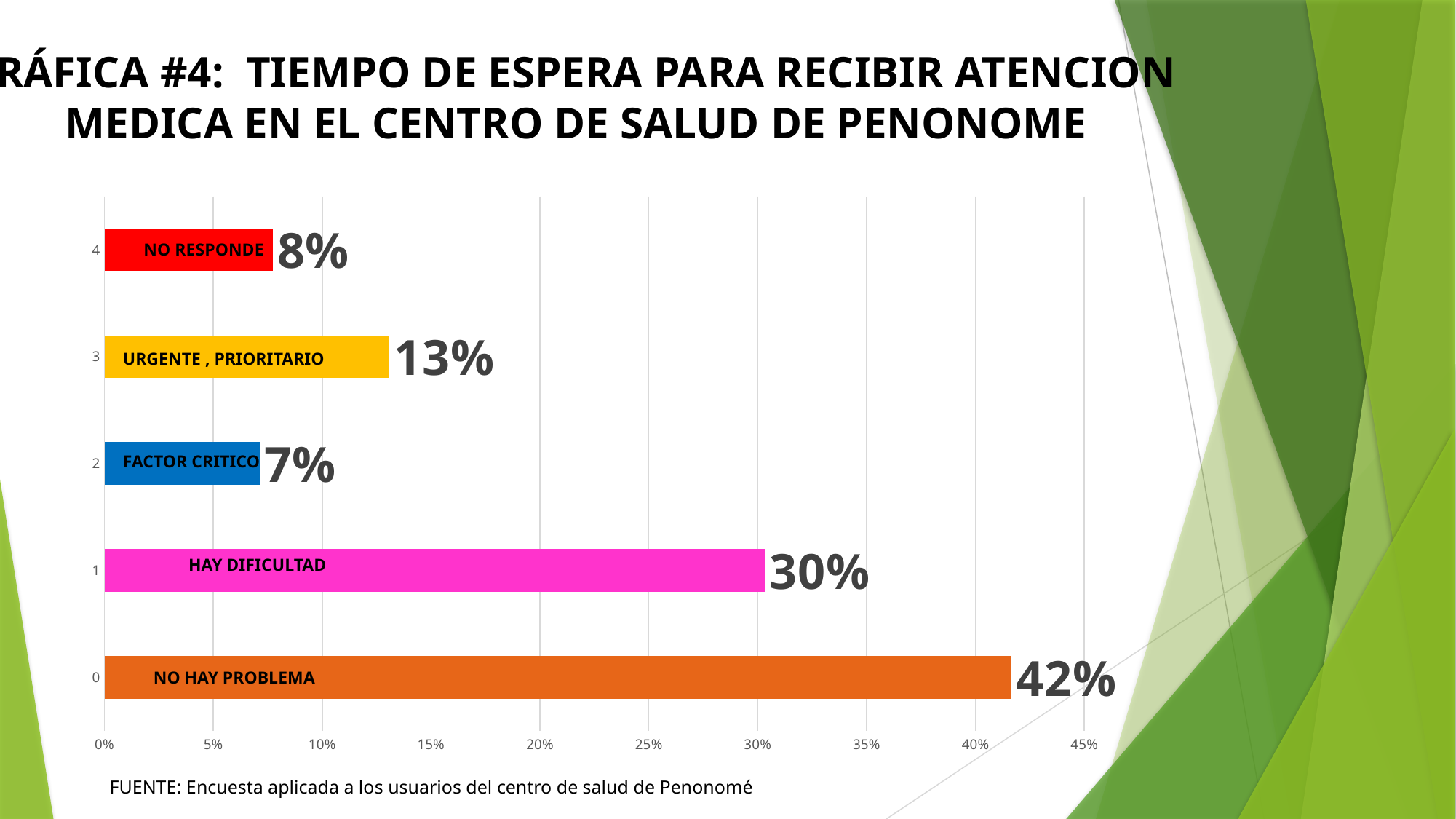
Which category has the highest value? NO HAY PROBLEMA Which category has the lowest value? FACTOR CRITICO What is the value for URGENTE , PRIORITARIO? 13% What is the value for FACTOR CRITICO? 7% What is the value for NO HAY PROBLEMA? 42% How many categories are shown in the chart? 5 Which is larger, the value for URGENTE , PRIORITARIO or the value for NO RESPONDE? URGENTE , PRIORITARIO What colour is the bar for HAY DIFICULTAD? Pink (magenta) What is the value for NO RESPONDE? 8% What is the difference between the values for NO HAY PROBLEMA and HAY DIFICULTAD? 12% What is the value for HAY DIFICULTAD? 30% What kind of chart is shown on the slide? Bar chart